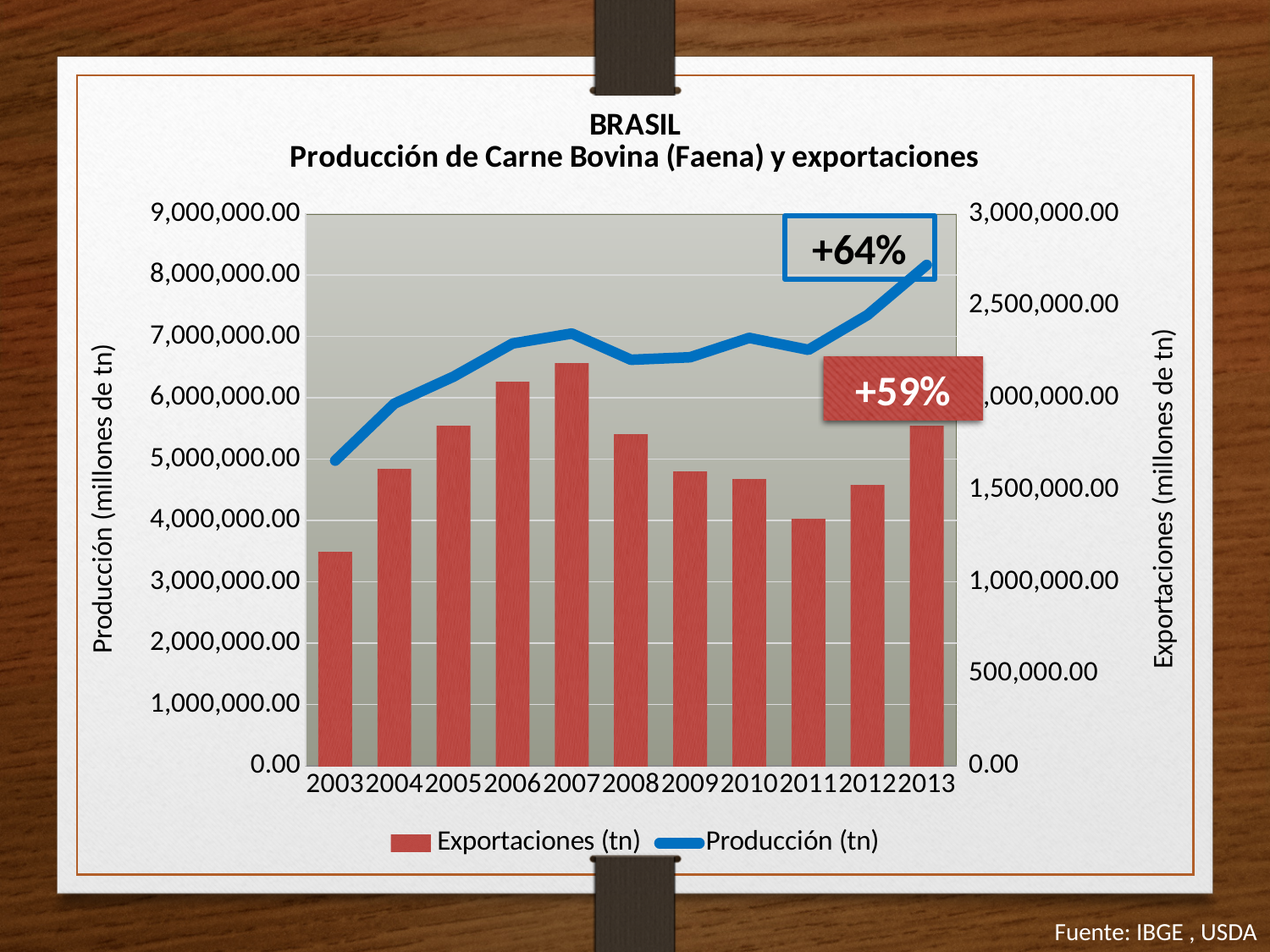
Which year has the highest Exportaciones (tn) bar? 2007 Is the Producción (tn) value for 2013 greater or less than 8,000,000.00? greater Is the Exportaciones (tn) value for 2007 greater or less than 2,000,000.00? greater How many series does the legend list? 2 What percentage is shown in the blue box next to the Producción line? +64% Is the Exportaciones (tn) bar for 2007 larger or smaller than the bar for 2011? larger Which year has the lowest Exportaciones (tn) bar? 2003 Which year has the highest value on the Producción (tn) line? 2013 What type of chart is shown on the slide? A combined bar and line chart How many years are shown on the x axis? 11 Does the Producción (tn) line generally rise or fall from 2003 to 2013? rise Is the Exportaciones (tn) value for 2003 greater or less than 1,500,000.00? less